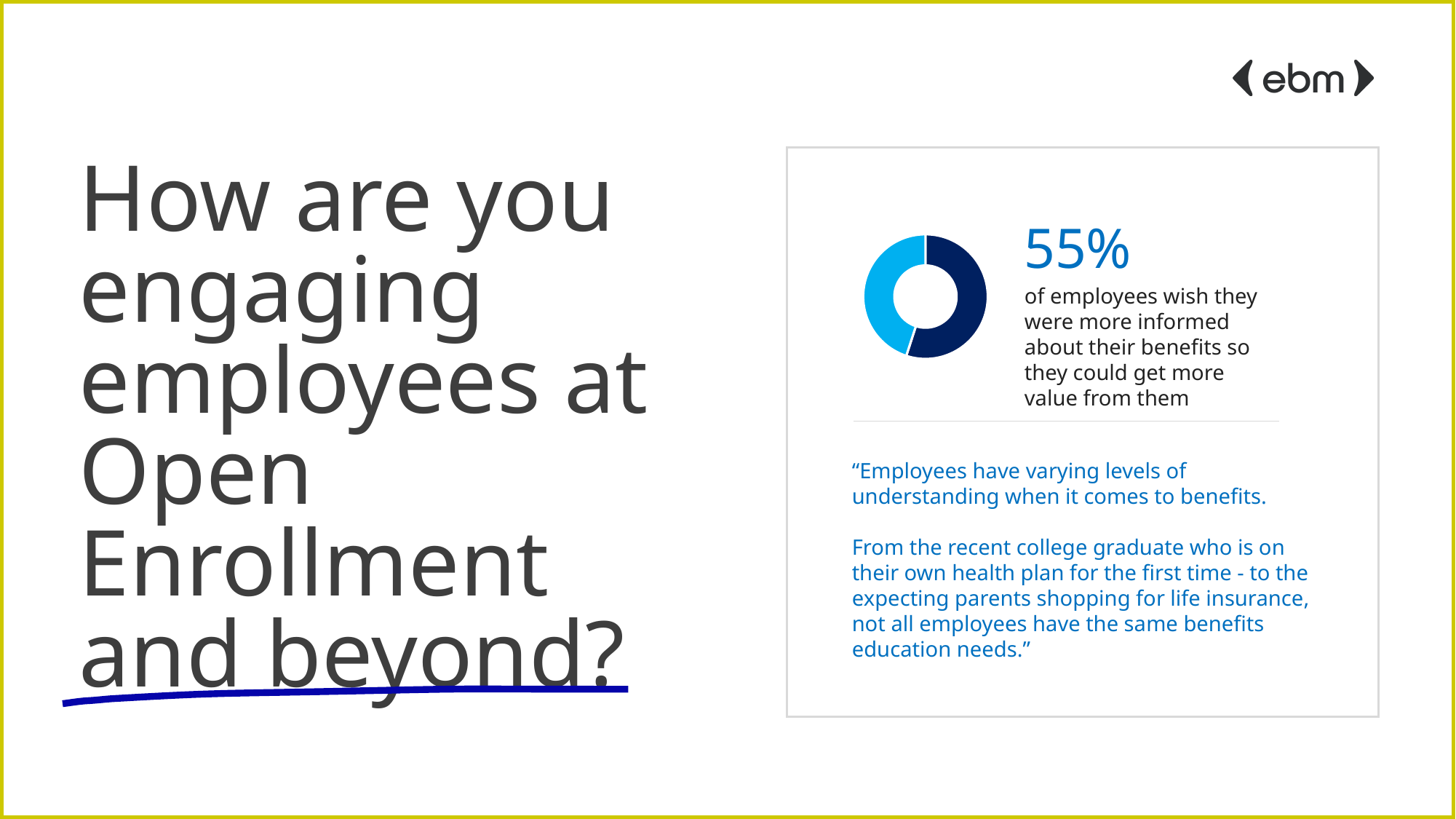
What kind of chart is shown on the slide? Donut (pie) chart What percentage of employees wish they were more informed about their benefits, according to the donut chart? 55% How many slices does the donut chart have? 2 Is the share of employees who wish they were more informed about their benefits greater or less than 50%? greater What colour is the slice of the donut chart that represents the 55% figure? Dark navy blue Which slice of the donut chart is larger, the dark navy one or the light blue one? The dark navy one What share of the donut chart is represented by the light blue slice (the remainder)? 45% What statistic is highlighted in large blue text next to the donut chart? 55%